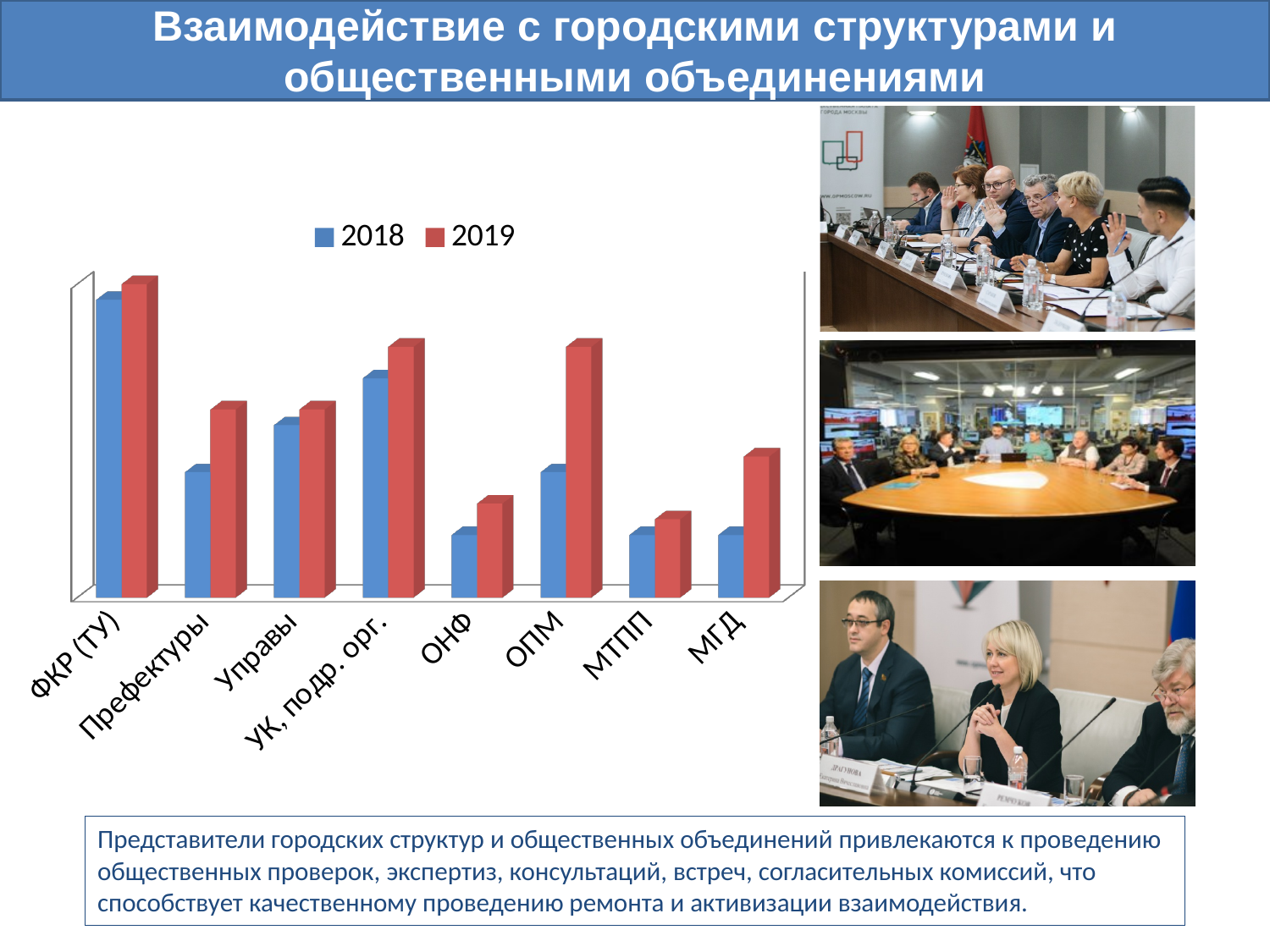
In the 2018 series, which is larger: Управы or Префектуры? Управы In the 2018 series, which is larger: УК, подр. орг. or ОНФ? УК, подр. орг. In the 2019 series, which is larger: МГД or МТПП? МГД What are the two entries listed in the chart legend? 2018 and 2019 How many series does the chart legend list? 2 What kind of chart is shown on the slide? bar chart Which series is shown in red in the chart? 2019 Which category has the highest value for the 2019 series? ФКР (ТУ) Which category has the highest value for the 2018 series? ФКР (ТУ) How many categories are shown on the x axis of the chart? 8